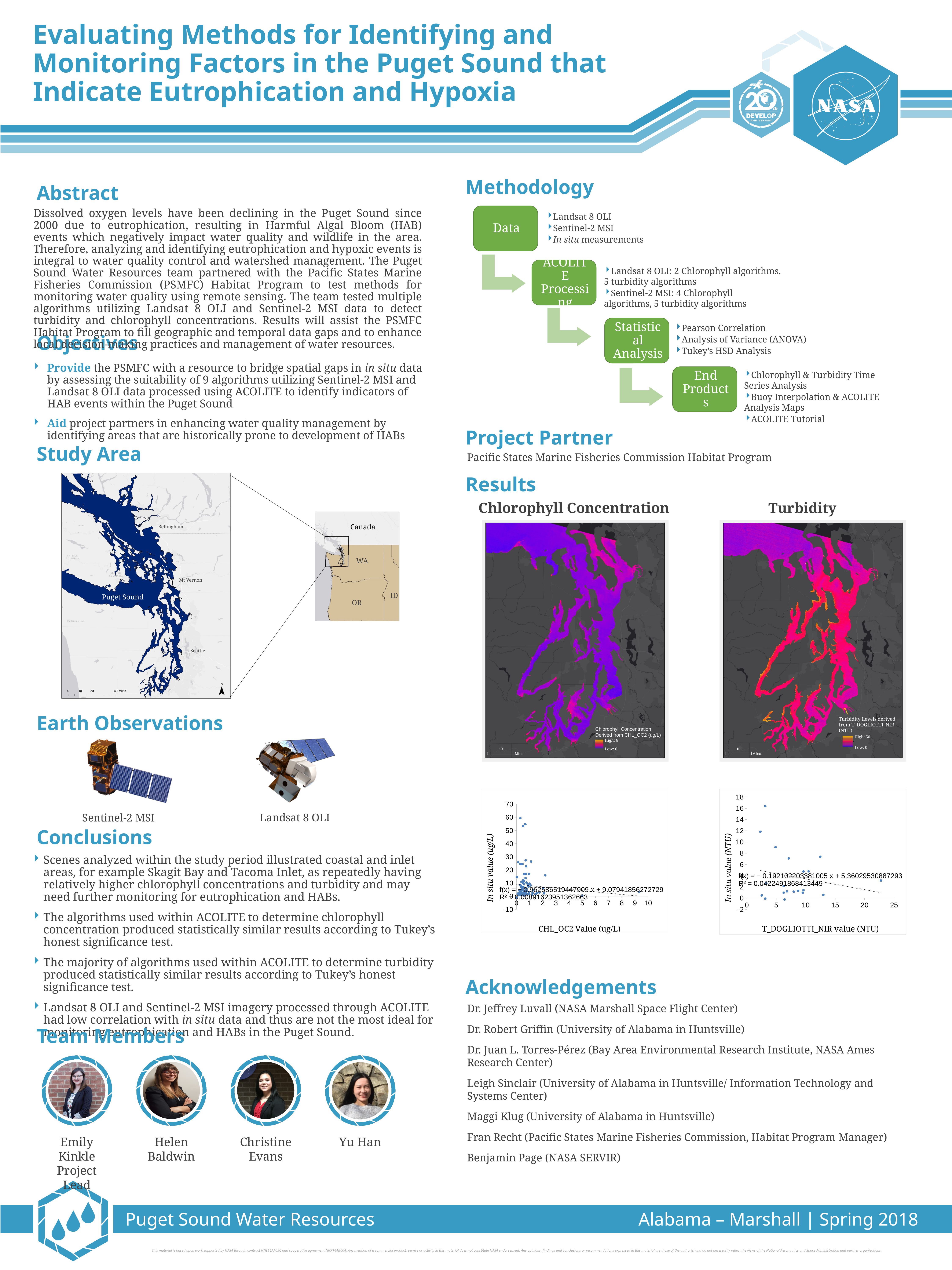
What kind of chart is the Turbidity chart in the Results section? scatter chart In the Chlorophyll Concentration scatter chart, what R² value is printed for the trendline? 0.00891623951362663 In the Turbidity scatter chart, what is the x-axis title? T_DOGLIOTTI_NIR value (NTU) In the Turbidity scatter chart, what is the trendline equation printed on the chart? f(x) = −0.192102203381005 x + 5.36029530887293 In the Turbidity scatter chart, does the trendline rise or fall as the T_DOGLIOTTI_NIR value increases? fall In the Turbidity scatter chart, is the highest in situ value plotted greater or less than 14? greater Which chart has the larger printed R² value, the Chlorophyll Concentration chart or the Turbidity chart? Turbidity What kind of chart is the Chlorophyll Concentration chart in the Results section? scatter chart In the Chlorophyll Concentration scatter chart, does the trendline rise or fall as the CHL_OC2 value increases? fall In the Chlorophyll Concentration scatter chart, is the highest in situ value plotted greater or less than 50? greater In the Turbidity scatter chart, what R² value is printed for the trendline? 0.0422491868413449 In the Chlorophyll Concentration scatter chart, what is the x-axis title? CHL_OC2 Value (ug/L)